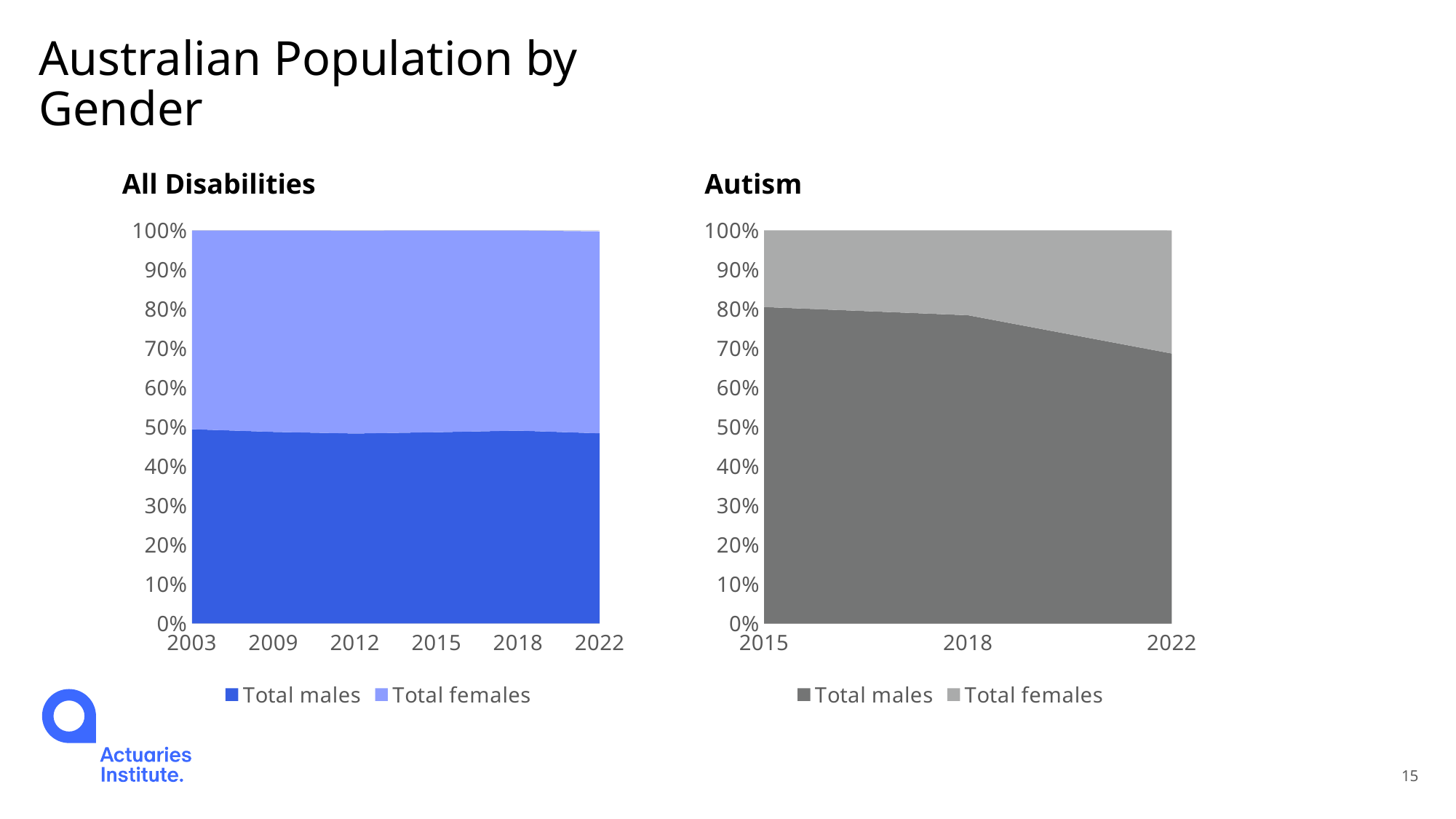
How many years are labelled on the x axis of the Autism chart? 3 What kind of chart is the All Disabilities chart? stacked area chart What are the two legend entries of the All Disabilities chart? Total males, Total females How many years are labelled on the x axis of the All Disabilities chart? 6 What kind of chart is the Autism chart? stacked area chart In the All Disabilities chart, is the Total males share in 2022 greater or less than 40%? greater In the Autism chart, which is larger in 2022, the Total males share or the Total females share? Total males In the Autism chart, does the Total males share rise or fall from 2015 to 2022? fall How many series does the legend of the Autism chart list? 2 In the Autism chart, in which year is the Total males share highest? 2015 In the Autism chart, is the Total males share in 2015 greater or less than 70%? greater In the Autism chart, is the Total males share in 2022 greater or less than 80%? less